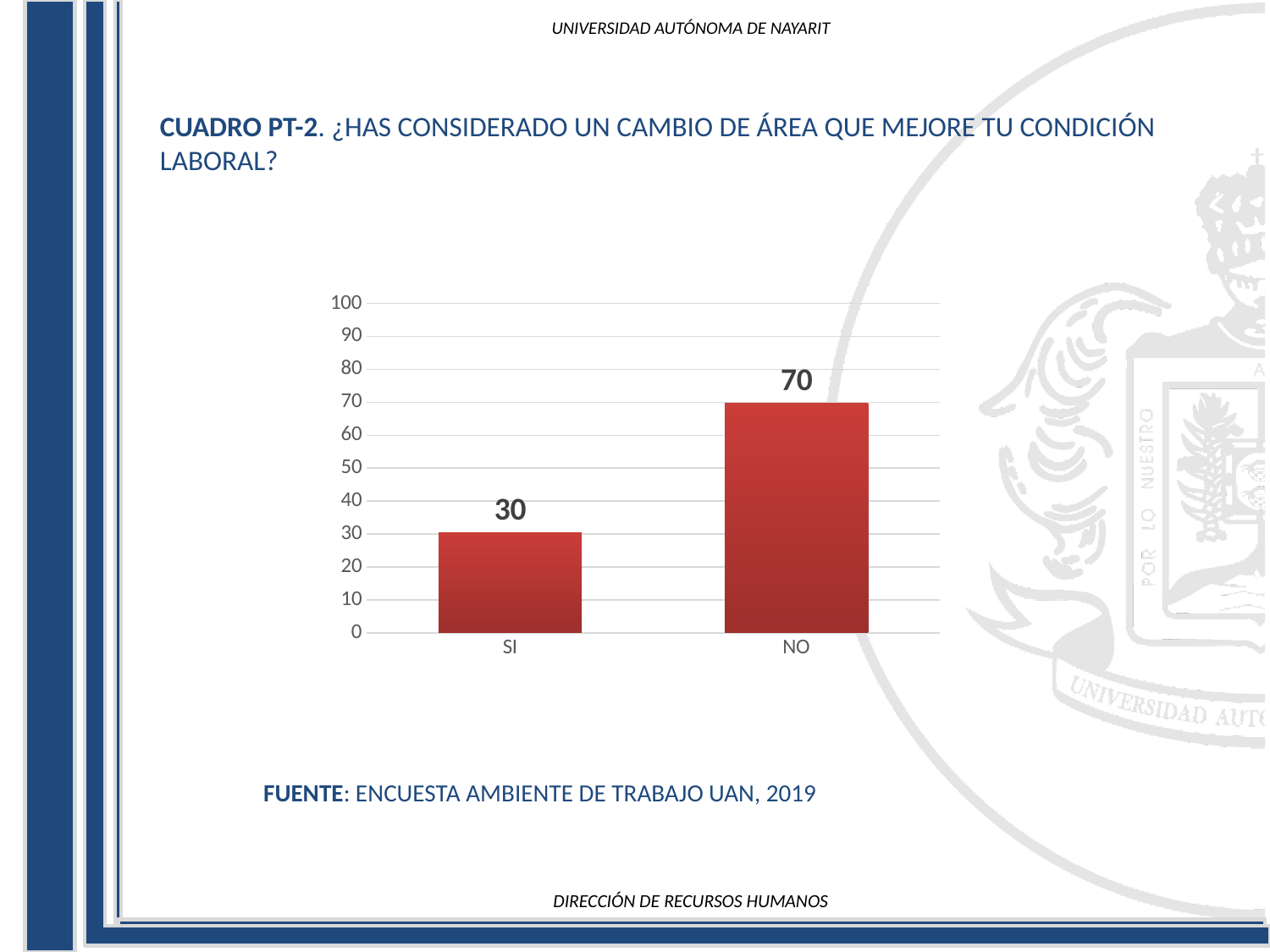
Which category has the highest value? NO How many categories are shown on the x axis? 2 Which is larger, the value for SI or the value for NO? NO Is the value for SI greater or less than 40? less What is the value for NO? 70 Is the value for NO greater or less than 50? greater What is the difference between the values for NO and SI? 40 What is the total of the values for SI and NO? 100 What kind of chart is shown on the slide? bar chart What is the maximum value shown on the vertical axis? 100 Which category has the lowest value? SI What is the value for SI? 30